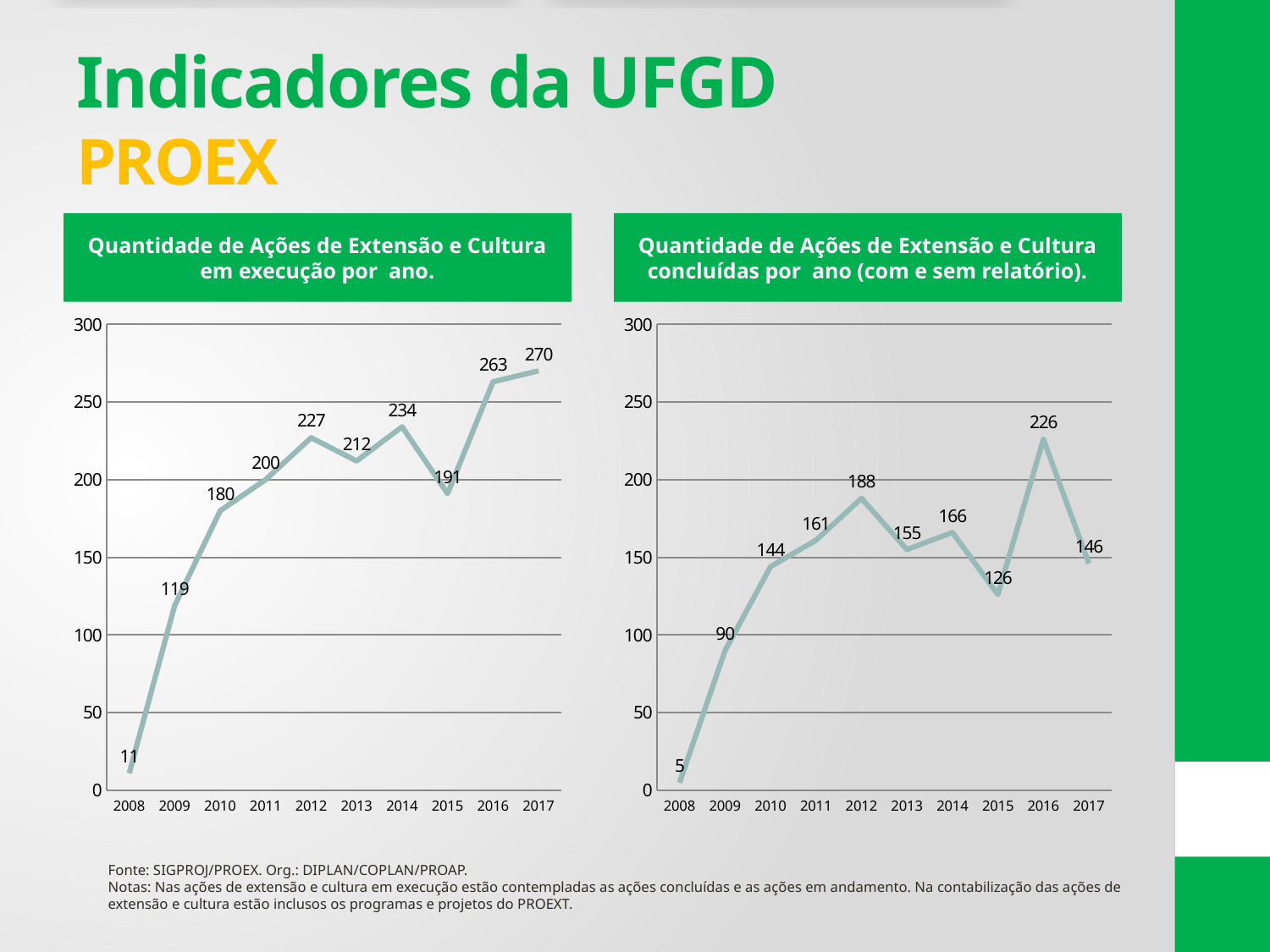
In the left chart (em execução por ano), which is larger, the value for 2014 or the value for 2015? 2014 In the left chart (em execução por ano), do the values rise or fall from 2008 to 2012? rise How many years are plotted in the left chart (em execução por ano)? 10 In the left chart (em execução por ano), what is the difference between the values for 2017 and 2008? 259 In the right chart (Quantidade de Ações de Extensão e Cultura concluídas por ano), what is the value for 2014? 166 In the right chart (concluídas por ano), which year has the lowest value? 2008 In the right chart (concluídas por ano), what is the difference between the values for 2016 and 2015? 100 In the left chart (Quantidade de Ações de Extensão e Cultura em execução por ano), what is the value for 2012? 227 In the right chart (concluídas por ano), is the value for 2012 greater or less than 150? greater In the left chart (em execução por ano), which year has the highest value? 2017 What kind of chart is the right chart (concluídas por ano)? line chart In the right chart (concluídas por ano), which year has the highest value? 2016